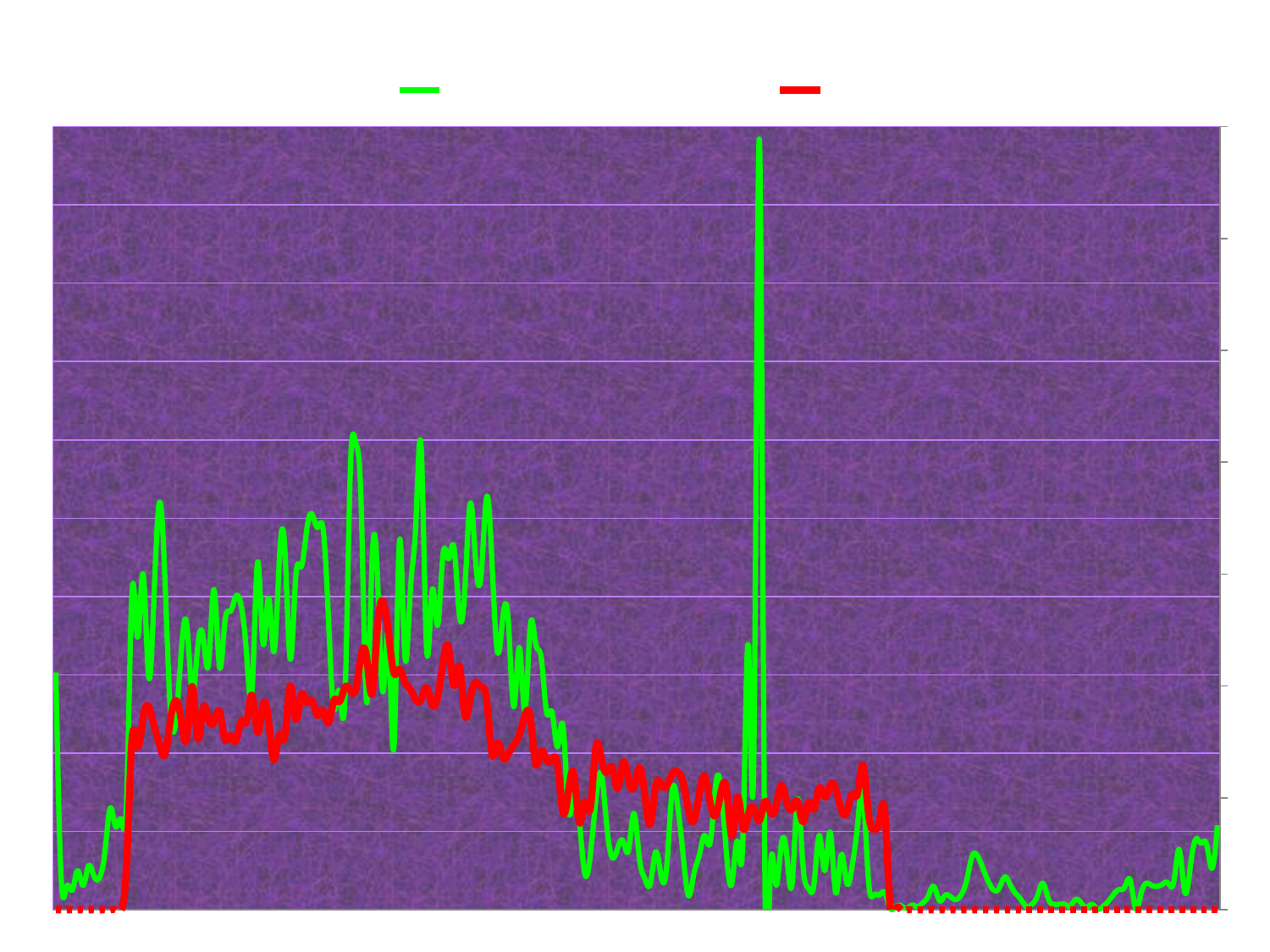
What colours are the two lines in the chart? green and red How many series does the legend list? 2 What kind of chart is shown on the slide? line chart Does the red line end at the bottom of the chart or near the top at the right edge? bottom Which line has the tallest single spike, the green or the red? green Which line reaches the highest point on the chart, the green line or the red line? green